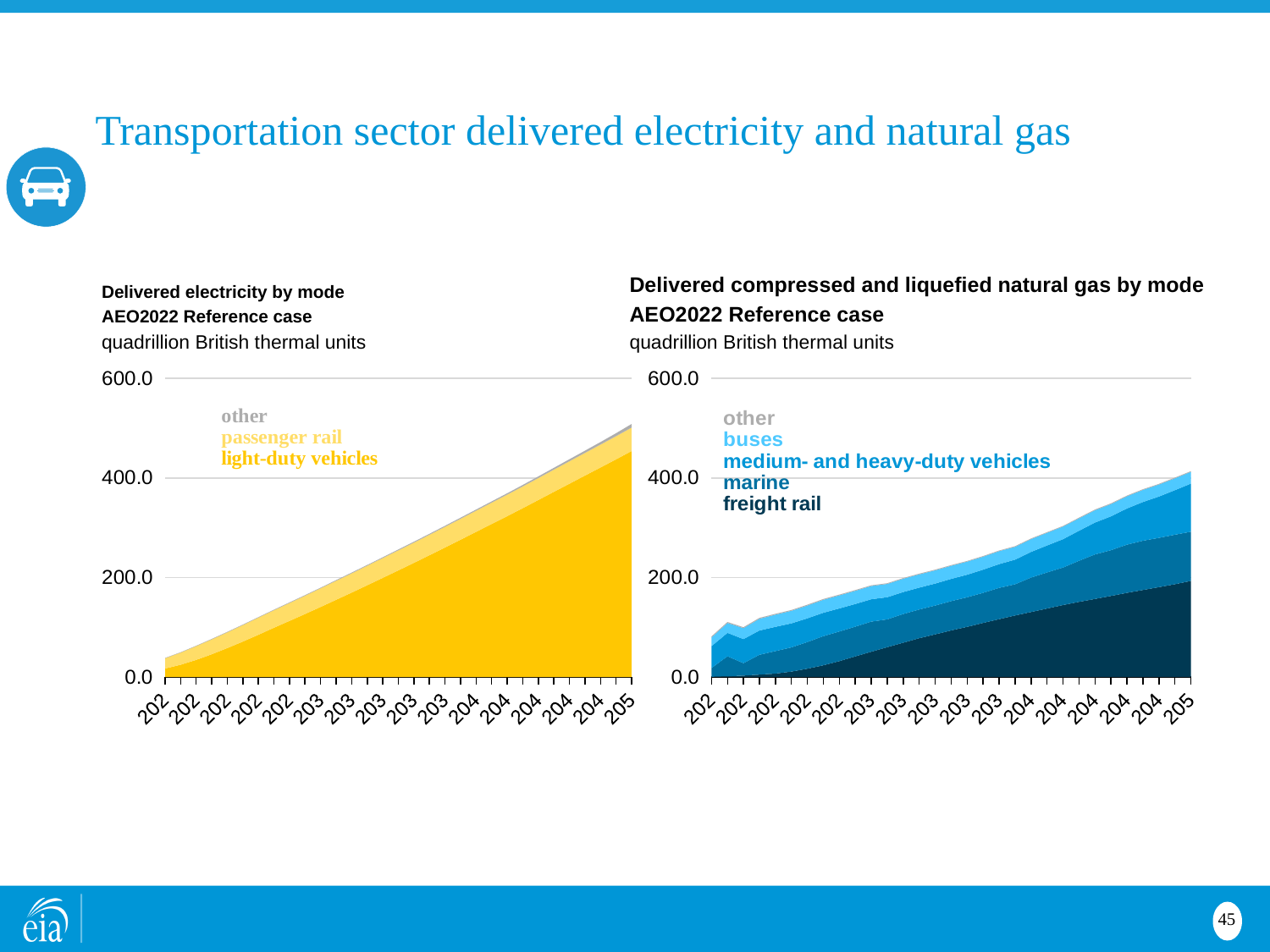
In the 'Delivered electricity by mode' chart, which mode accounts for the largest share of delivered electricity? light-duty vehicles In the 'Delivered electricity by mode' chart, does the total delivered electricity rise or fall over time along the x axis? Rise In the 'Delivered compressed and liquefied natural gas by mode' chart, does the total rise or fall over time along the x axis? Rise In the 'Delivered compressed and liquefied natural gas by mode' chart, which mode accounts for the largest share at the end of the projection period? freight rail How many series does the legend of the 'Delivered compressed and liquefied natural gas by mode' chart list? 5 What kind of chart is the 'Delivered compressed and liquefied natural gas by mode' chart on the right? Stacked area chart What unit of measurement is used on the y axis of both charts? quadrillion British thermal units In the 'Delivered electricity by mode' chart, is the total value at the end of the projection period greater or less than 400.0? greater In the 'Delivered compressed and liquefied natural gas by mode' chart, is the total value at the end of the projection period greater or less than 600.0? less How many series does the legend of the 'Delivered electricity by mode' chart list? 3 In the 'Delivered electricity by mode' chart, is the total value at the start of the projection period greater or less than 200.0? less What kind of chart is the 'Delivered electricity by mode' chart on the left? Stacked area chart